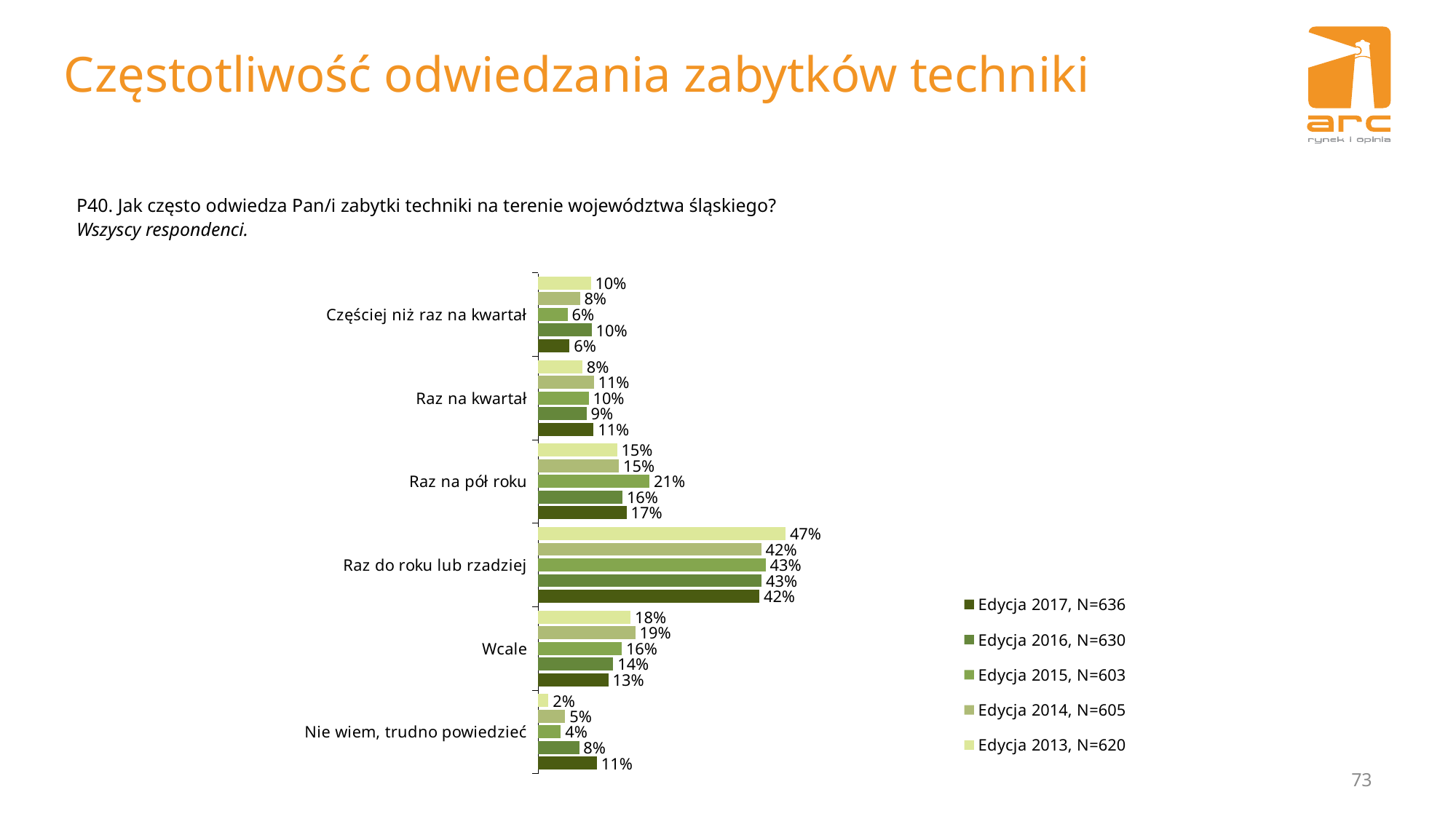
What is the value for 'Nie wiem, trudno powiedzieć' in Edycja 2017, N=636? 11% Which edition in the legend has the largest sample size (N)? Edycja 2017, N=636 What is the value for 'Raz do roku lub rzadziej' in Edycja 2013, N=620? 47% How many series does the legend list? 5 What is the value for 'Raz na pół roku' in Edycja 2015, N=603? 21% What kind of chart is shown on the slide? bar chart How many response categories are shown on the chart? 6 Which response category has the lowest value in Edycja 2013, N=620? Nie wiem, trudno powiedzieć Which is larger for 'Częściej niż raz na kwartał': the Edycja 2016 value or the Edycja 2017 value? Edycja 2016 Which response category has the highest value in Edycja 2017, N=636? Raz do roku lub rzadziej What is the difference between the Edycja 2017 and Edycja 2013 values for 'Nie wiem, trudno powiedzieć'? 9% What is the difference between the Edycja 2013 and Edycja 2017 values for 'Wcale'? 5%